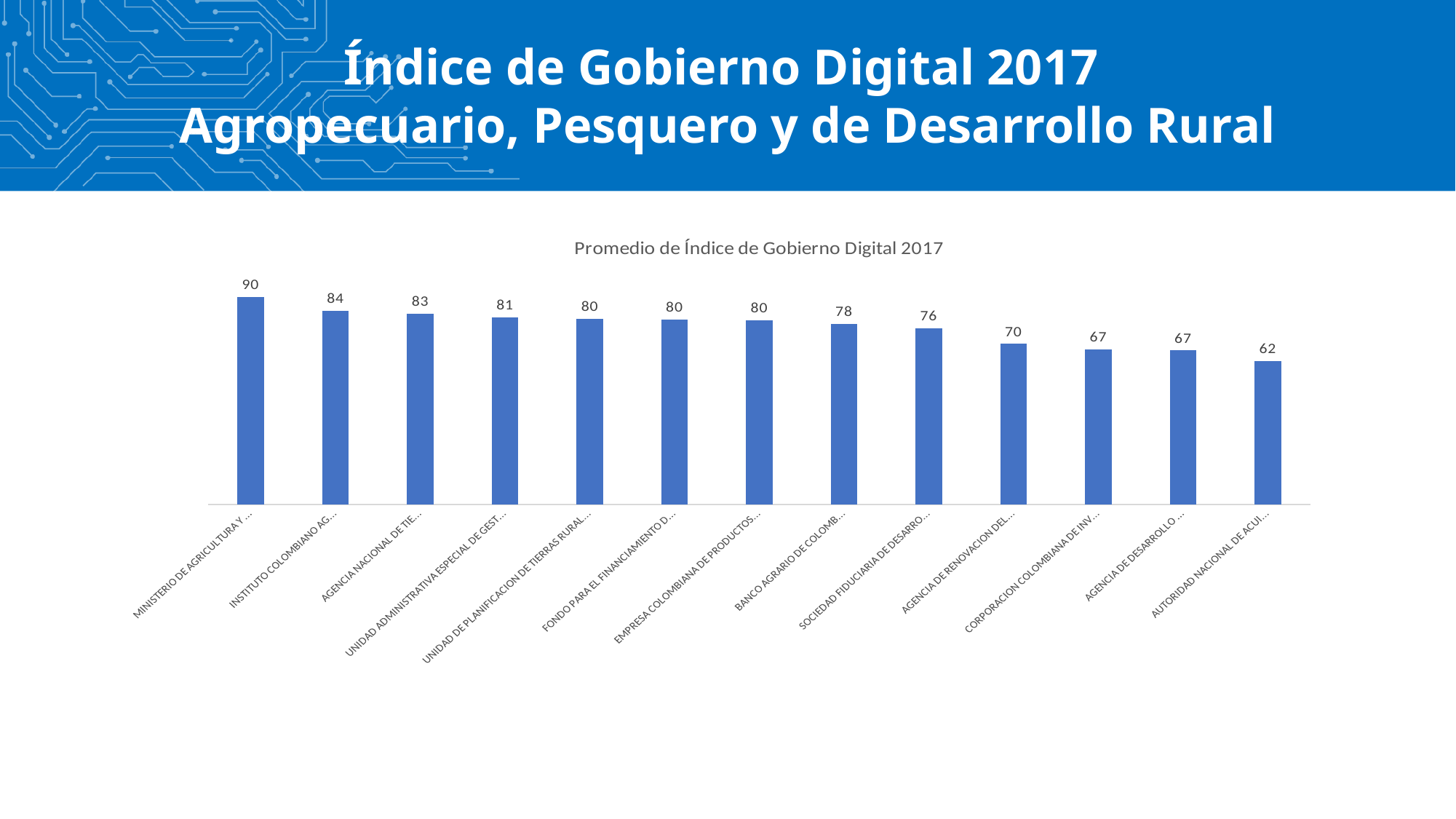
What is the difference between the highest value (90) and the lowest value (62)? 28 What is the title of the chart? Promedio de Índice de Gobierno Digital 2017 Which is larger, the value for "AGENCIA NACIONAL DE TIE..." or the value for "CORPORACION COLOMBIANA DE INV..."? AGENCIA NACIONAL DE TIE... What is the difference between the values for "INSTITUTO COLOMBIANO AG..." and "SOCIEDAD FIDUCIARIA DE DESARRO..."? 8 What is the value for the bar labelled "AUTORIDAD NACIONAL DE ACUI..."? 62 How many bars are shown in the chart? 13 Which category has the highest value? MINISTERIO DE AGRICULTURA Y ... Which category has the lowest value? AUTORIDAD NACIONAL DE ACUI... What type of chart is shown on the slide? Bar chart What is the value for the bar labelled "BANCO AGRARIO DE COLOMB..."? 78 What is the value for the bar labelled "MINISTERIO DE AGRICULTURA Y ..."? 90 What is the value for the bar labelled "AGENCIA DE RENOVACION DEL..."? 70